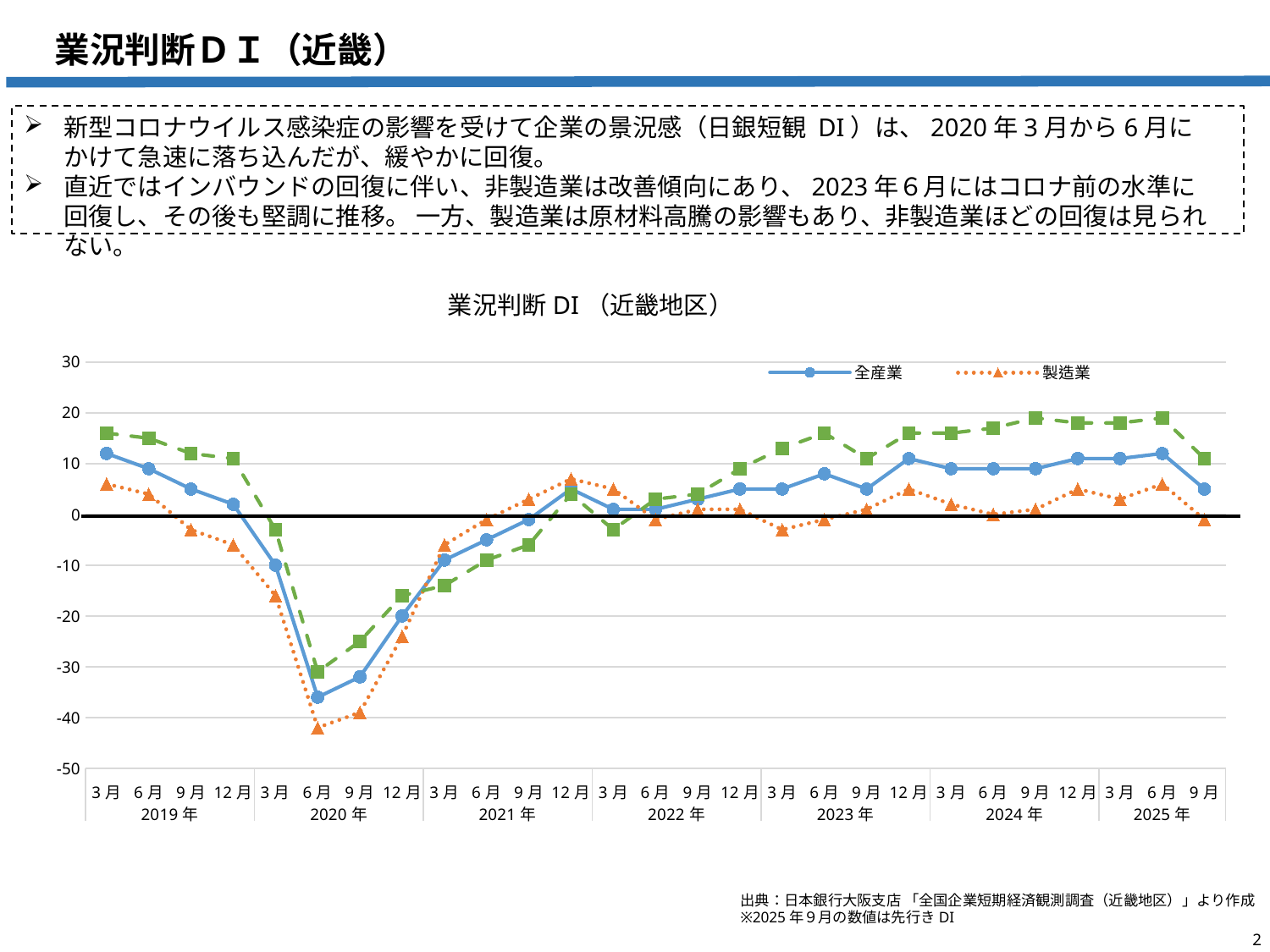
How many time points are plotted along the x axis? 27 Is the value for 全産業 in 2020年6月 greater or less than -30? less In 2020年6月, which series has the lower value, 全産業 or 製造業? 製造業 At which time point does the 全産業 series reach its lowest value? 2020年6月 Is the value for 製造業 in 2020年6月 greater or less than -30? less What is the title of the chart? 業況判断DI（近畿地区） Is the value for 全産業 in 2019年3月 greater or less than 10? greater Which series are named in the chart's legend? 全産業, 製造業 What kind of chart is shown on the slide? line chart At which time point does the 製造業 series reach its lowest value? 2020年6月 How many series does the chart's legend list? 2 Does the 全産業 series rise or fall from 2019年3月 to 2020年6月? fall